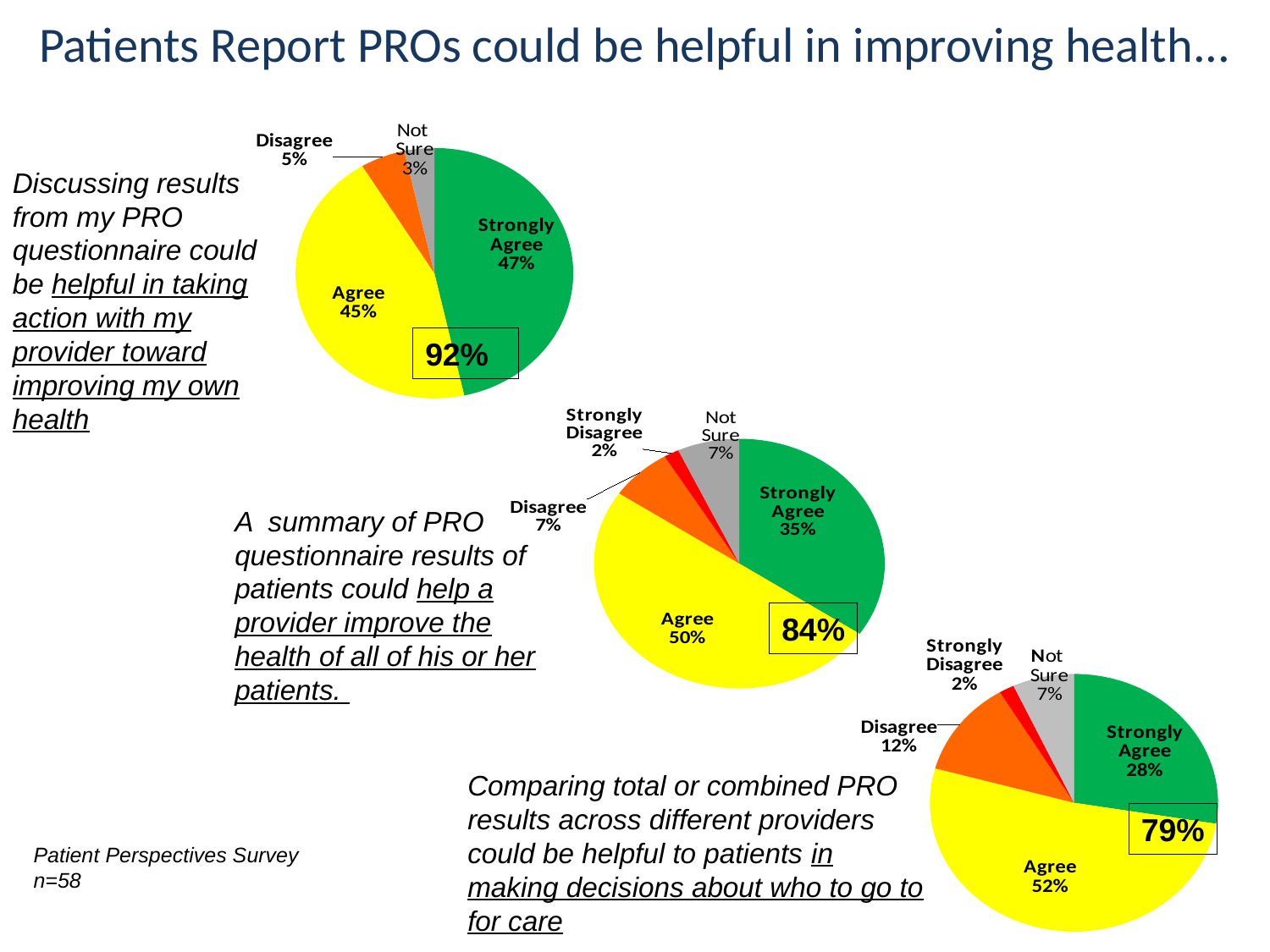
In the middle pie chart, what share of respondents answered Agree? 50% In the bottom-right pie chart, what share of respondents answered Disagree? 12% In the top-left pie chart, what share of respondents answered Strongly Agree? 47% In the bottom-right pie chart, what combined percentage is shown in the boxed label? 79% What type of chart is used on this slide? Pie chart In the top-left pie chart, how many slices does the pie have? 4 In the bottom-right pie chart, which is larger, the Strongly Agree slice or the Agree slice? Agree In the middle pie chart, what is the difference between the Agree and Strongly Agree shares? 15% In the top-left pie chart, which response category has the smallest slice? Not Sure In the middle pie chart, which response category has the largest slice? Agree In the middle pie chart, how many slices does the pie have? 5 In the top-left pie chart, what share of respondents answered Disagree? 5%